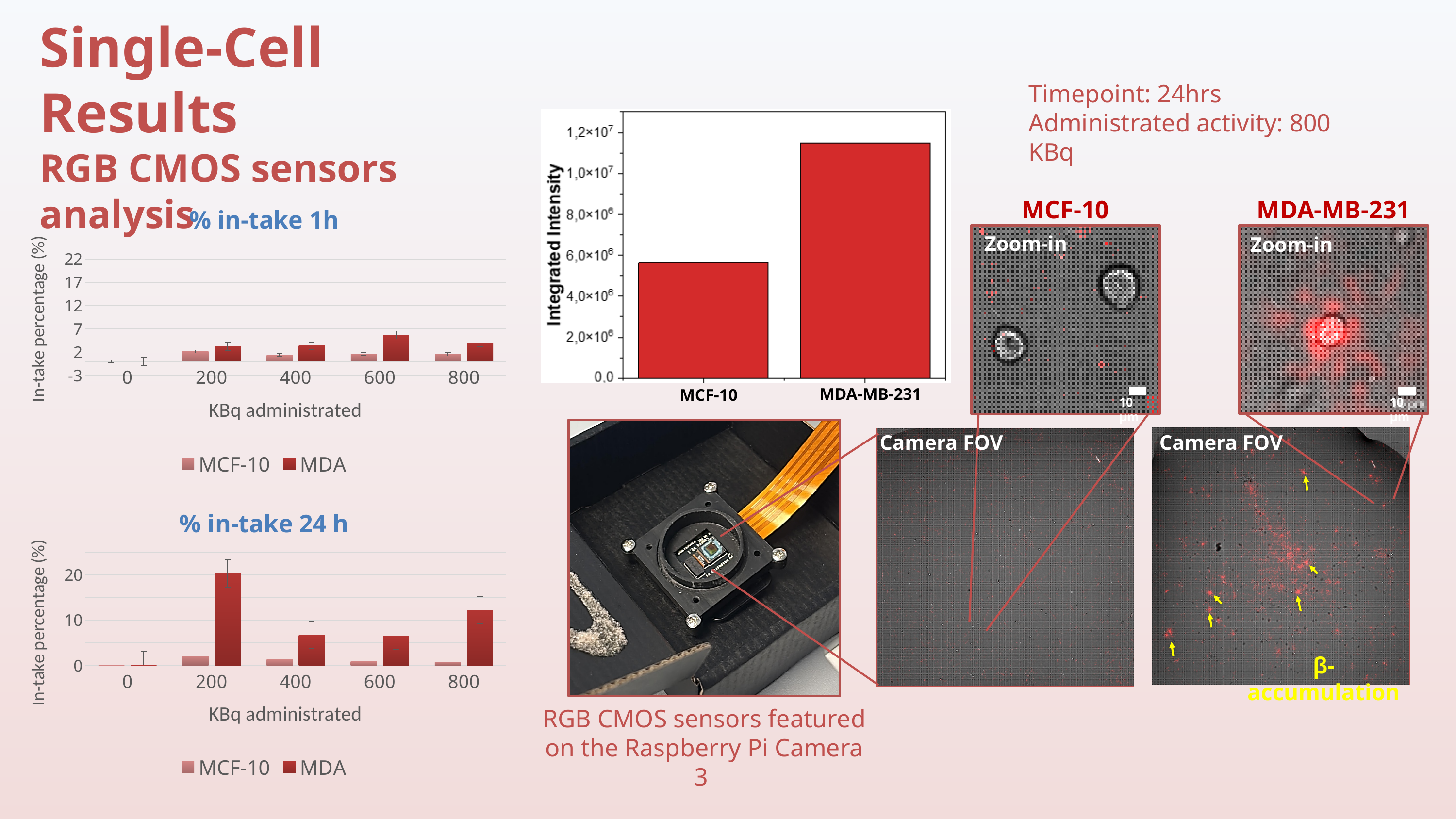
In the '% in-take 1h' chart, how many KBq administrated categories are shown on the x axis? 5 In the Integrated Intensity chart, is the value for MCF-10 greater or less than 8,0×10^6? less In the '% in-take 1h' chart, is the MCF-10 value at 400 KBq greater or less than 7? less In the '% in-take 24 h' chart, is the MDA value at 400 KBq greater or less than 10? less In the Integrated Intensity chart, which category has the higher bar, MCF-10 or MDA-MB-231? MDA-MB-231 In the '% in-take 1h' chart, how many series does the legend list? 2 In the '% in-take 24 h' chart, do the MCF-10 values rise or fall from 200 to 800 KBq? fall In the '% in-take 1h' chart, at which KBq administrated level is the MDA bar highest? 600 In the '% in-take 24 h' chart, which series has the larger value at 200 KBq, MCF-10 or MDA? MDA In the '% in-take 24 h' chart, at which KBq administrated level is the MDA bar highest? 200